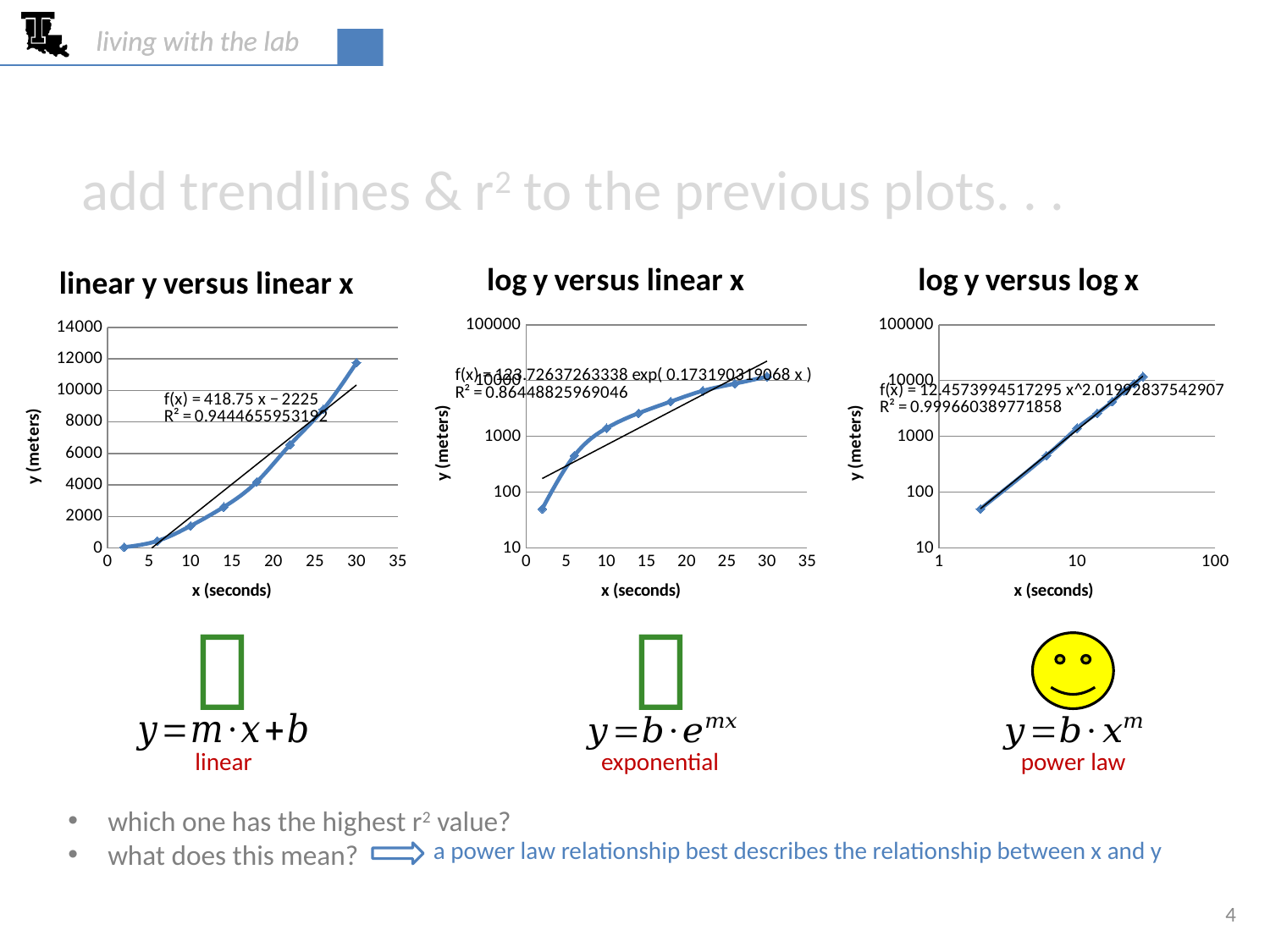
In the "log y versus log x" chart, do the y values rise or fall as x increases? rise What R² value is printed on the "log y versus linear x" chart? 0.86448825969046 How many data points are plotted in the "linear y versus linear x" chart? 8 In the "linear y versus linear x" chart, is the y value at x = 10 greater or less than 2000? less What is the x-axis title of the "linear y versus linear x" chart? x (seconds) What R² value is printed on the "log y versus log x" chart? 0.999660389771858 In the "log y versus linear x" chart, is the y value at x = 2 greater or less than 100? less In the "linear y versus linear x" chart, is the y value at x = 30 greater or less than 10000? greater Which of the three charts has the highest R² value? log y versus log x In the "linear y versus linear x" chart, do the y values rise or fall as x increases? rise What kind of chart is the "linear y versus linear x" chart? line chart